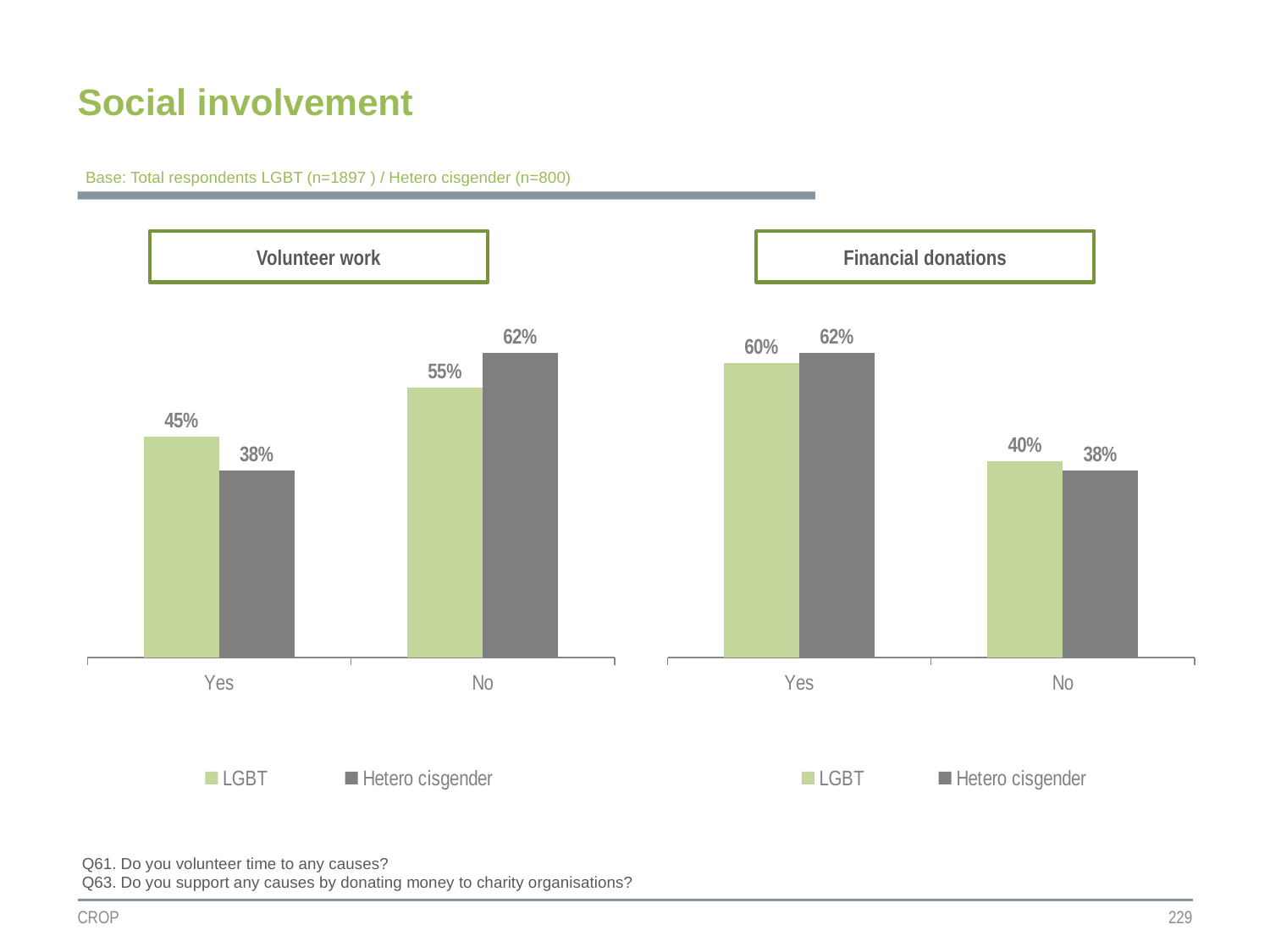
In the Financial donations chart, what is the value for LGBT respondents who answered Yes? 60% In the Volunteer work chart, what is the difference between the LGBT and Hetero cisgender values for Yes? 7% In the Financial donations chart, which bar has the lowest value? Hetero cisgender, No (38%) In the Financial donations chart, which group has the larger value for Yes, LGBT or Hetero cisgender? Hetero cisgender What type of chart is the Volunteer work chart? Bar chart How many series does the legend of the Financial donations chart list? 2 In the Volunteer work chart, which bar has the highest value? Hetero cisgender, No (62%) In the Volunteer work chart, what is the value for LGBT respondents who answered Yes? 45% In the Volunteer work chart, which group has the larger value for No, LGBT or Hetero cisgender? Hetero cisgender In the Financial donations chart, what is the difference between the LGBT and Hetero cisgender values for No? 2% In the Volunteer work chart, what is the value for Hetero cisgender respondents who answered No? 62% In the Financial donations chart, what is the value for Hetero cisgender respondents who answered No? 38%